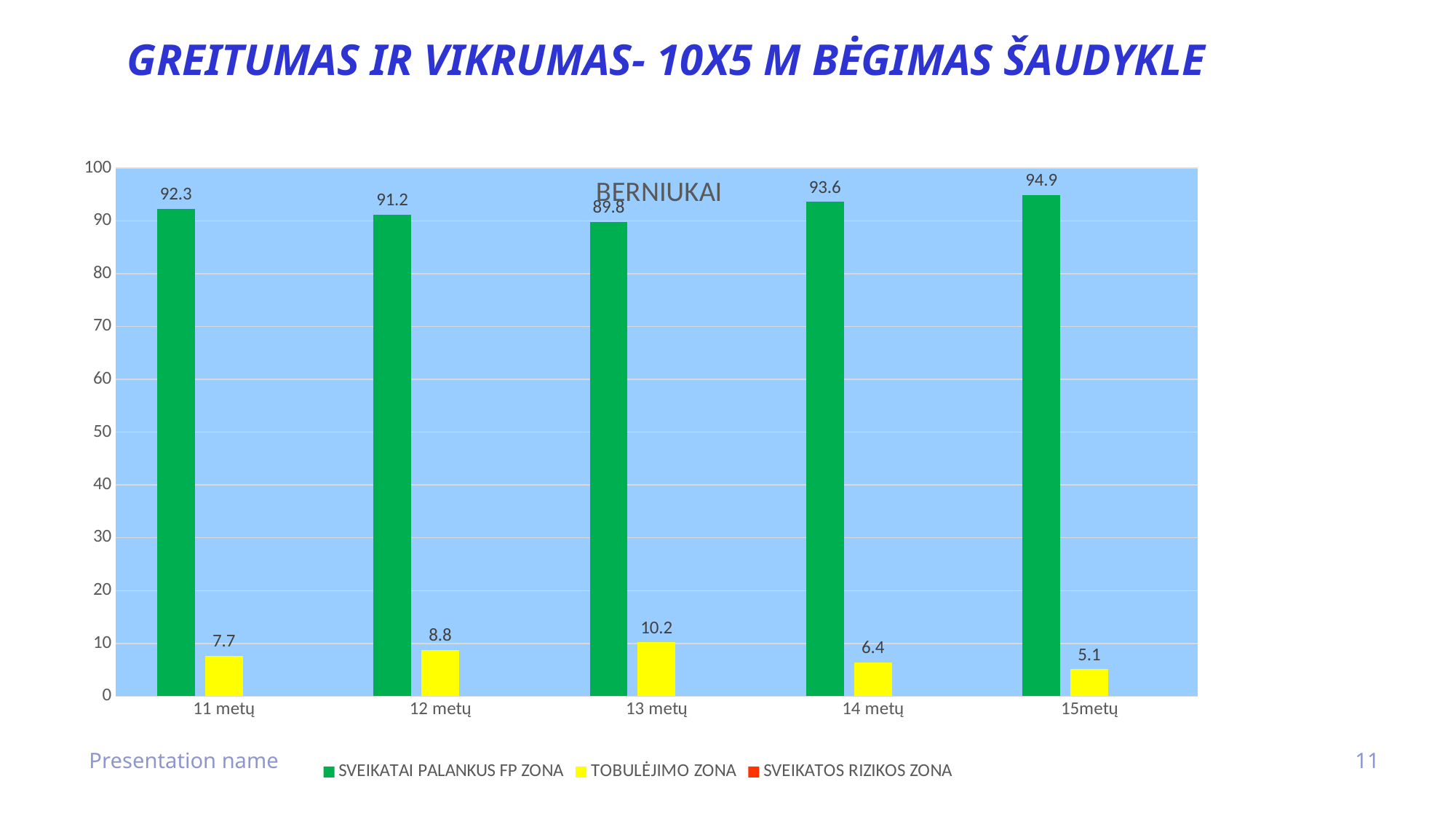
How many age groups are shown on the x axis? 5 What is the value of SVEIKATAI PALANKUS FP ZONA for 11 metų? 92.3 How many series does the legend list? 3 What kind of chart is shown on the slide? Bar chart Which age group has the highest SVEIKATAI PALANKUS FP ZONA value? 15metų What is the difference between the SVEIKATAI PALANKUS FP ZONA values for 15metų and 13 metų? 5.1 What is the value of TOBULĖJIMO ZONA for 13 metų? 10.2 Which age group has the lowest TOBULĖJIMO ZONA value? 15metų What is the title shown inside the chart area? BERNIUKAI Which age group has the lowest SVEIKATAI PALANKUS FP ZONA value? 13 metų Which is larger: the TOBULĖJIMO ZONA value for 12 metų or for 14 metų? 12 metų What is the value of TOBULĖJIMO ZONA for 15metų? 5.1